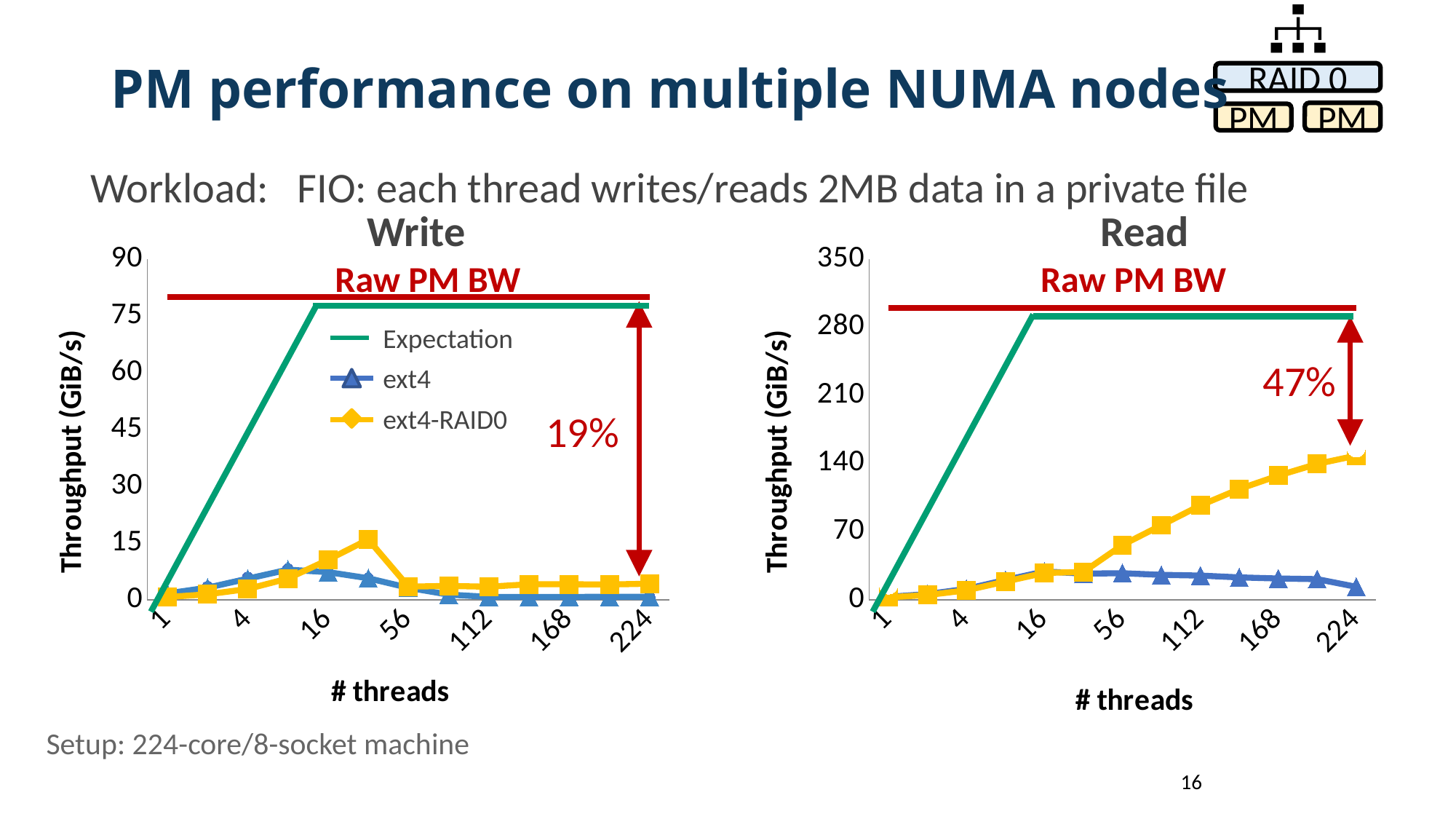
On the Read chart, at 224 threads, which is larger: ext4 or ext4-RAID0? ext4-RAID0 On the Read chart, what percentage is shown next to the red arrow? 47% On the Write chart, is the Expectation value at 224 threads greater or less than 60? greater On the Write chart, is the ext4-RAID0 value at 224 threads greater or less than 15? less On the Read chart, which series has the lowest value at 224 threads? ext4 What kind of chart is the Write chart? line chart On the Read chart, does the ext4-RAID0 series rise or fall as the number of threads increases? rise How many series does the legend on the Write chart list? 3 On the Read chart, is the ext4 value at 224 threads greater or less than 70? less On the Write chart, what percentage is shown next to the red arrow? 19%